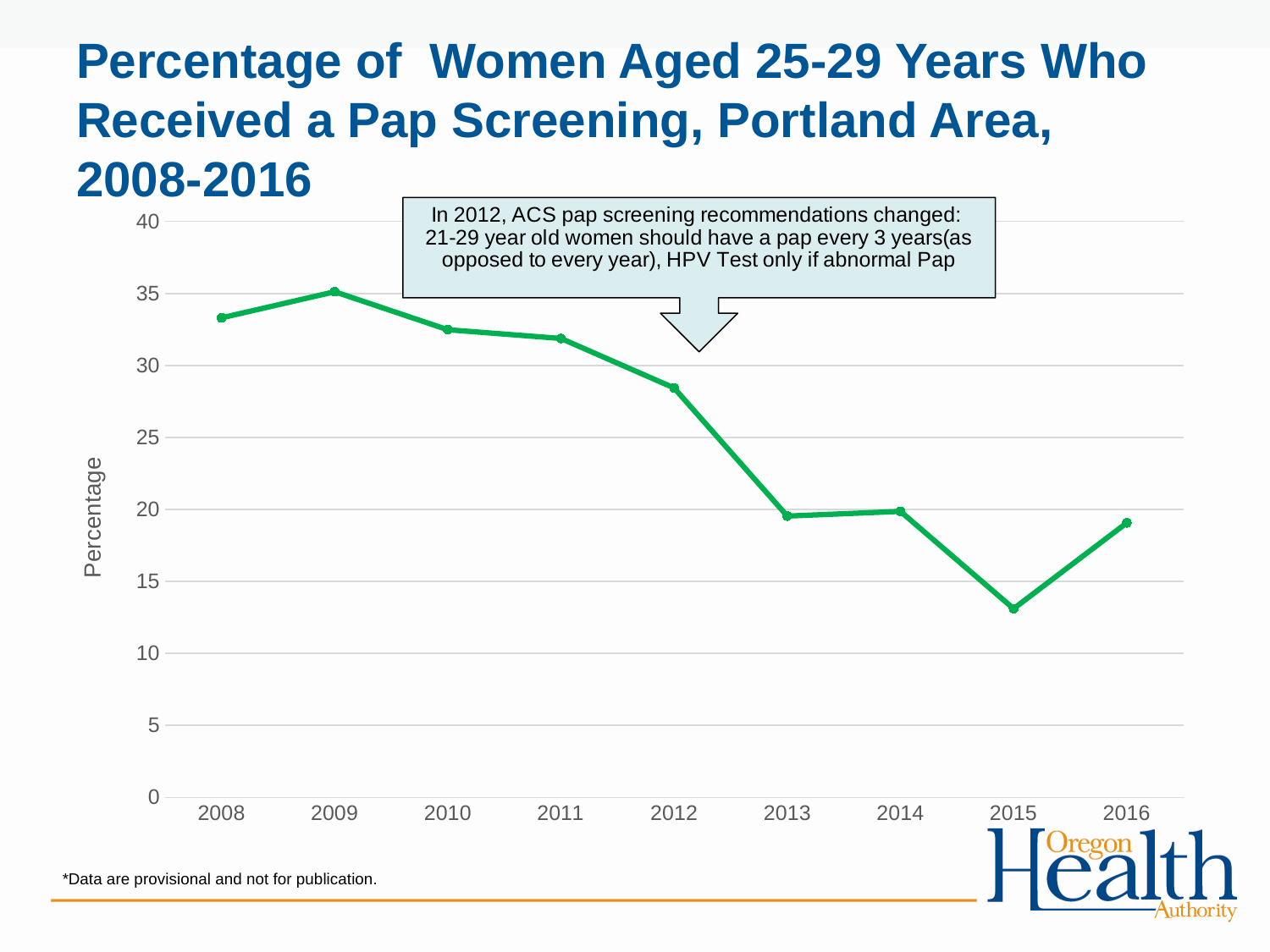
How many years (data points) are plotted on the chart? 9 Which year has the lowest percentage of women aged 25-29 who received a Pap screening? 2015 Is the value for 2013 greater or less than 25? less Overall, do the values rise or fall from 2008 to 2016? fall Which year has a higher value, 2015 or 2016? 2016 Which year has the highest percentage of women aged 25-29 who received a Pap screening? 2009 Is the value for 2012 greater or less than 30? less What is the label on the vertical axis of the chart? Percentage Is the value for 2008 greater or less than 30? greater Which year has a higher value, 2012 or 2013? 2012 What kind of chart is shown on the slide? line chart